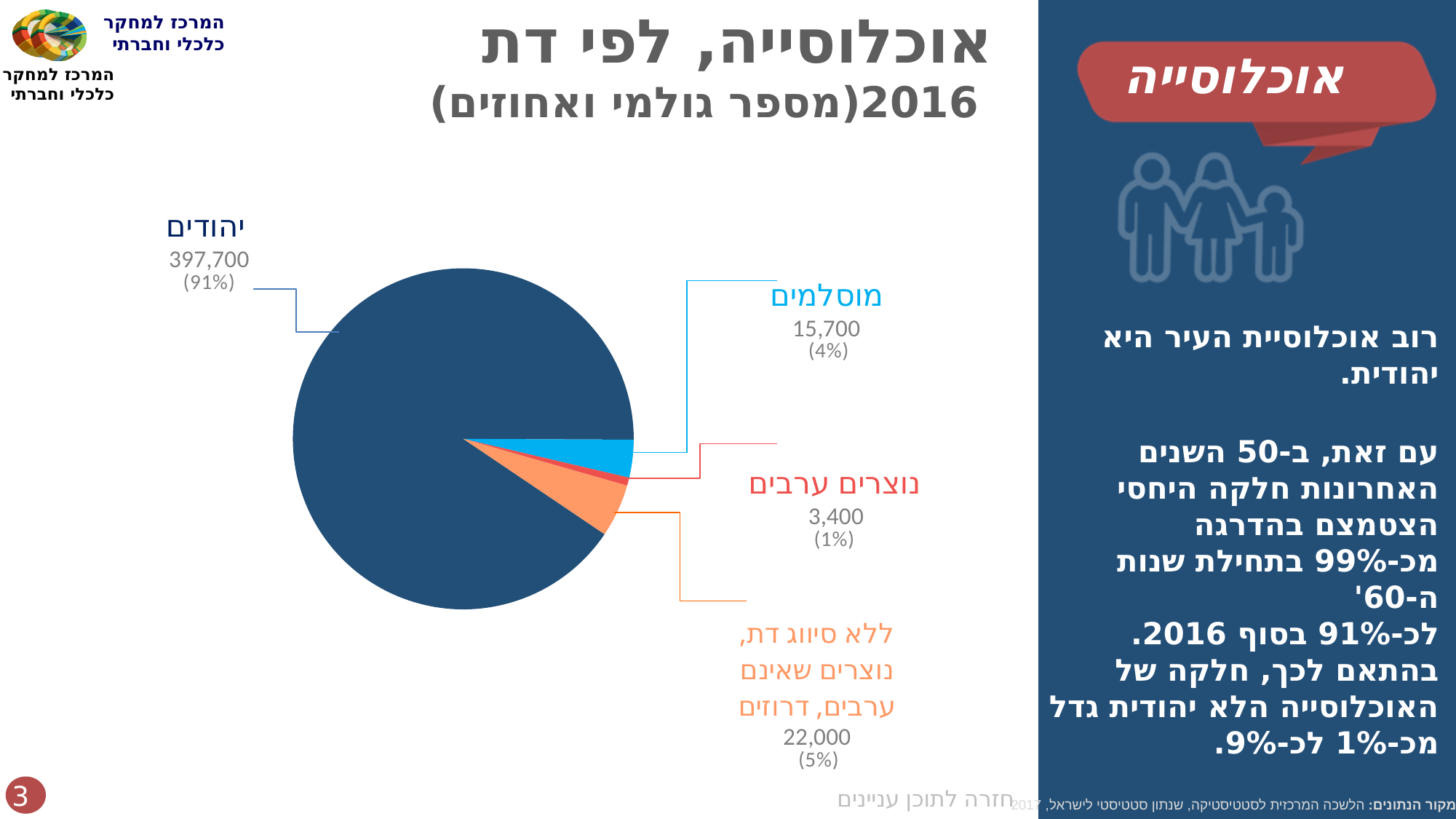
How many slices does the pie chart have? 4 Which category has the largest slice of the pie? יהודים What is the difference between the value for מוסלמים and the value for נוצרים ערבים? 12,300 What is the value shown for מוסלמים (Muslims)? 15,700 What is the value shown for נוצרים ערבים (Arab Christians)? 3,400 What is the value shown for יהודים (Jews) in the pie chart? 397,700 What is the value shown for the slice labelled ללא סיווג דת, נוצרים שאינם ערבים, דרוזים? 22,000 Which is larger: the value for מוסלמים or the value for ללא סיווג דת, נוצרים שאינם ערבים, דרוזים? ללא סיווג דת, נוצרים שאינם ערבים, דרוזים Which category has the smallest slice of the pie? נוצרים ערבים What kind of chart is shown on the slide? Pie chart What percentage share is shown for מוסלמים (Muslims)? 4% What percentage share is shown for יהודים (Jews)? 91%